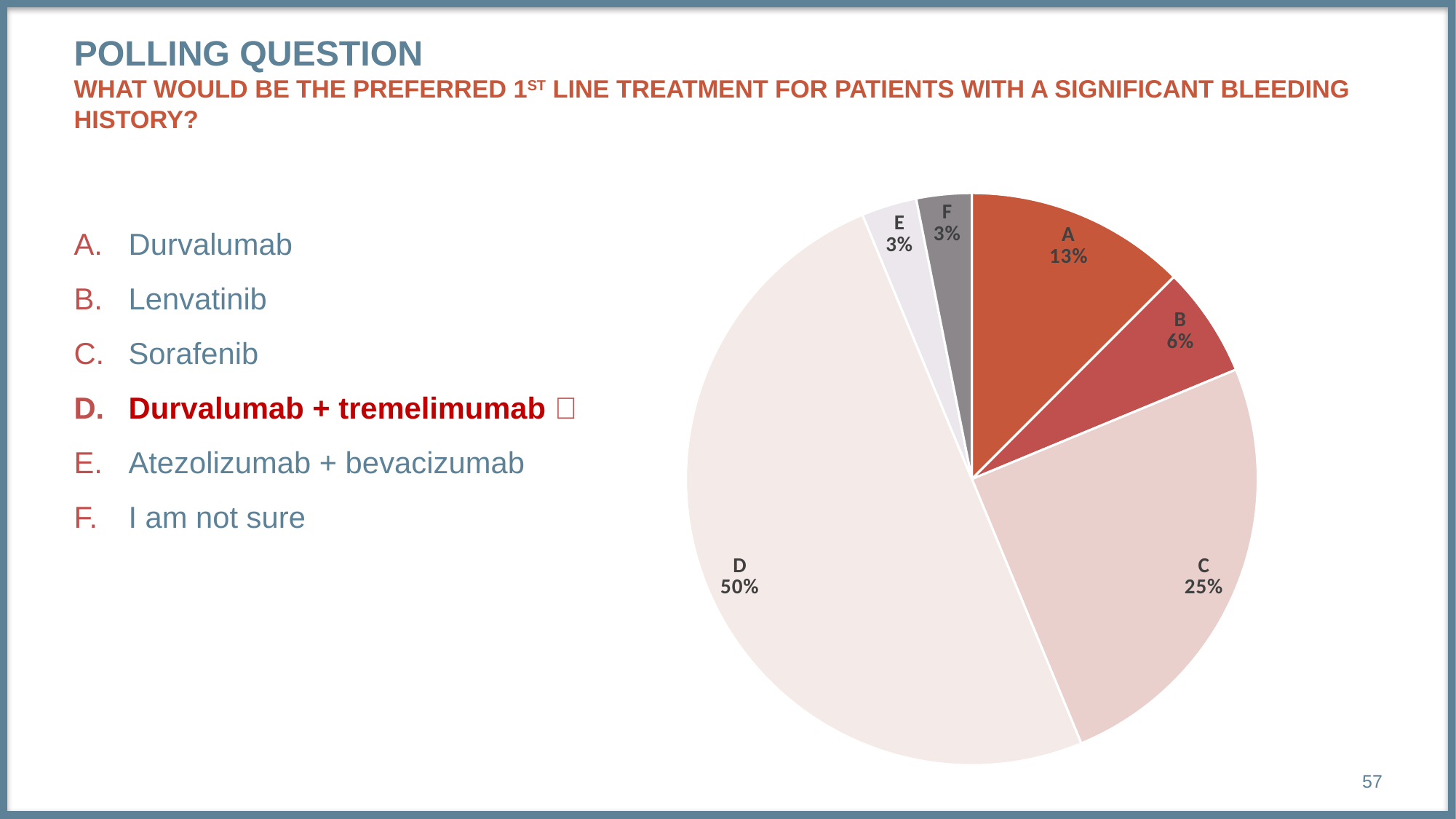
What kind of chart is shown on the slide? pie chart What is the difference between the values for slice A and slice B? 7% Which is larger, slice A or slice B? A What is the value shown for slice E? 3% What is the difference between the values for slice D and slice C? 25% What is the value shown for slice A? 13% How many slices does the pie chart have? 6 What is the value shown for slice B? 6% What is the value shown for slice C? 25% Which slice of the pie is the largest? D Which option does slice D correspond to in the list on the slide? Durvalumab + tremelimumab What share of the pie does slice D have? 50%